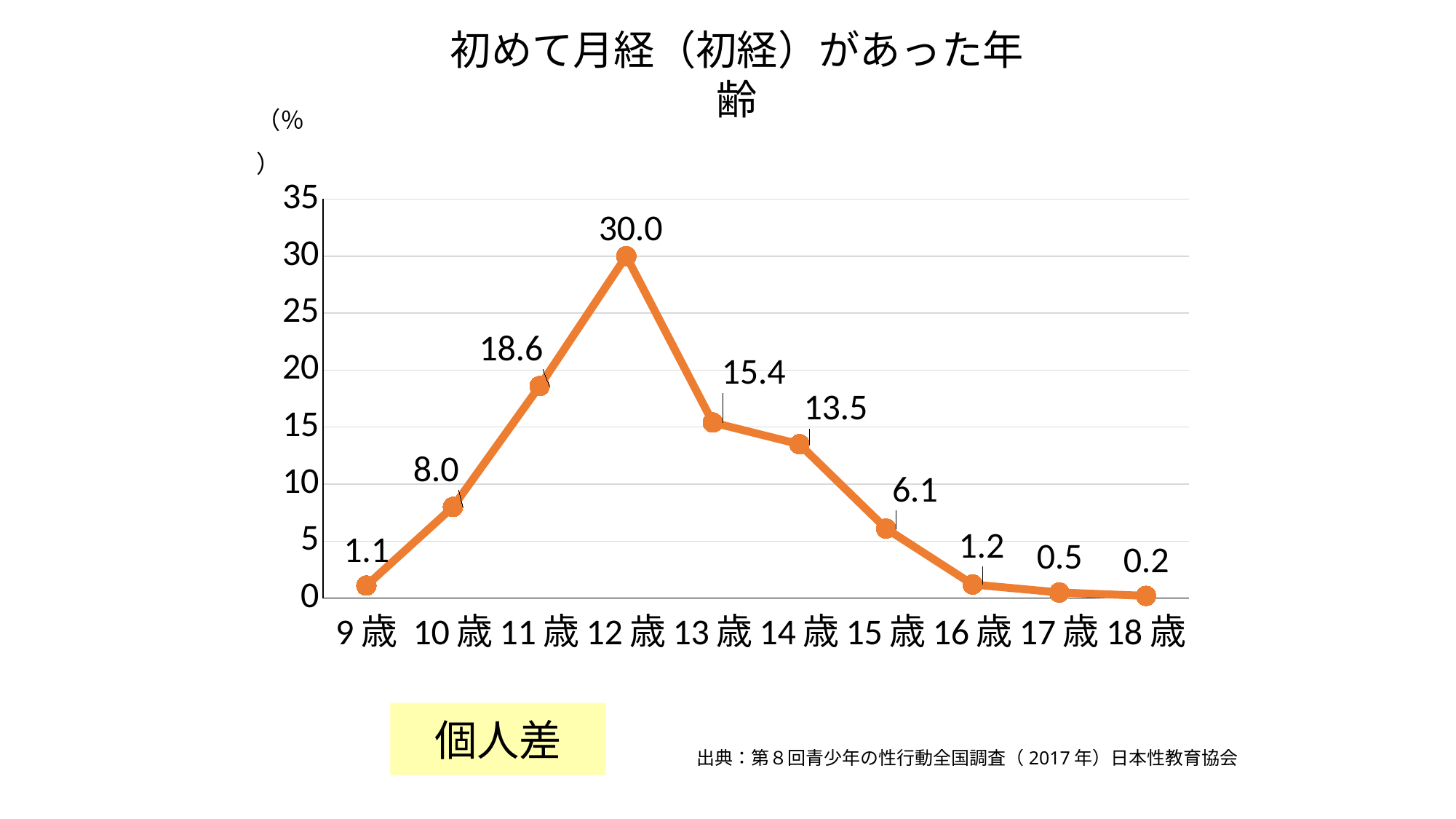
What is the title of the chart? 初めて月経（初経）があった年齢 What is the difference between the values for 12歳 and 11歳? 11.4 What kind of chart is shown? line chart Do the values rise or fall from 12歳 to 18歳? fall How many age categories are plotted on the x axis? 10 What is the value for 12歳? 30.0 Which age has the lowest value? 18歳 Which is larger, the value for 13歳 or the value for 14歳? 13歳 Is the value for 11歳 greater or less than 15? greater What is the value for 9歳? 1.1 What is the value for 14歳? 13.5 Which age has the highest value? 12歳